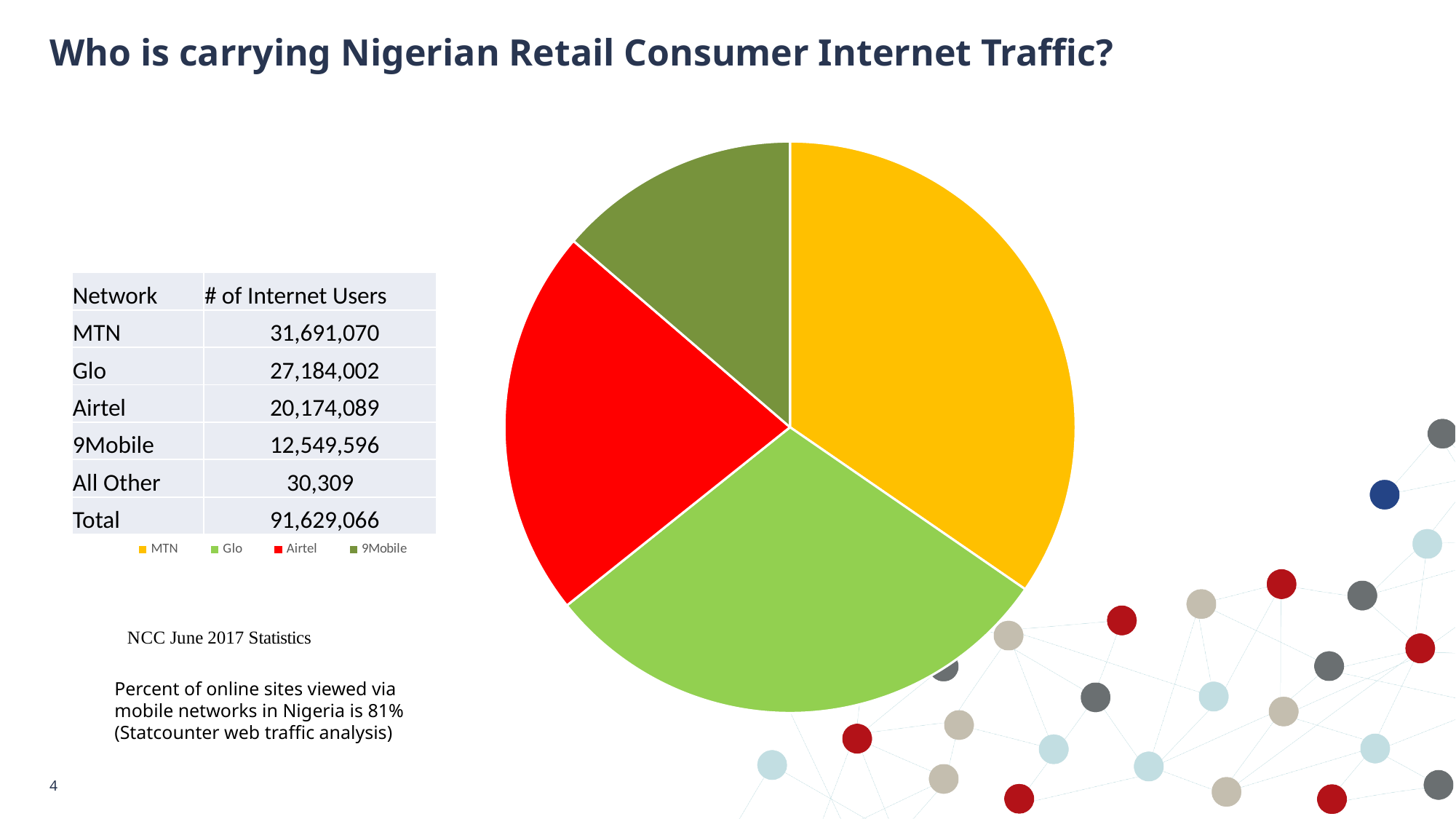
Which colour represents Airtel in the pie chart? red How many slices does the pie chart have? 4 What is the difference in internet users between Airtel and 9Mobile? 7,624,493 According to the table, how many internet users does 9Mobile have? 12,549,596 Which network has the largest slice of the pie chart? MTN What kind of chart is shown on the slide? pie chart Which network has the smallest slice of the pie chart? 9Mobile Which has more internet users, Airtel or Glo? Glo What is the difference in internet users between MTN and Glo? 4,507,068 According to the table, how many internet users does Airtel have? 20,174,089 According to the table, how many internet users does MTN have? 31,691,070 According to the table, how many internet users does Glo have? 27,184,002